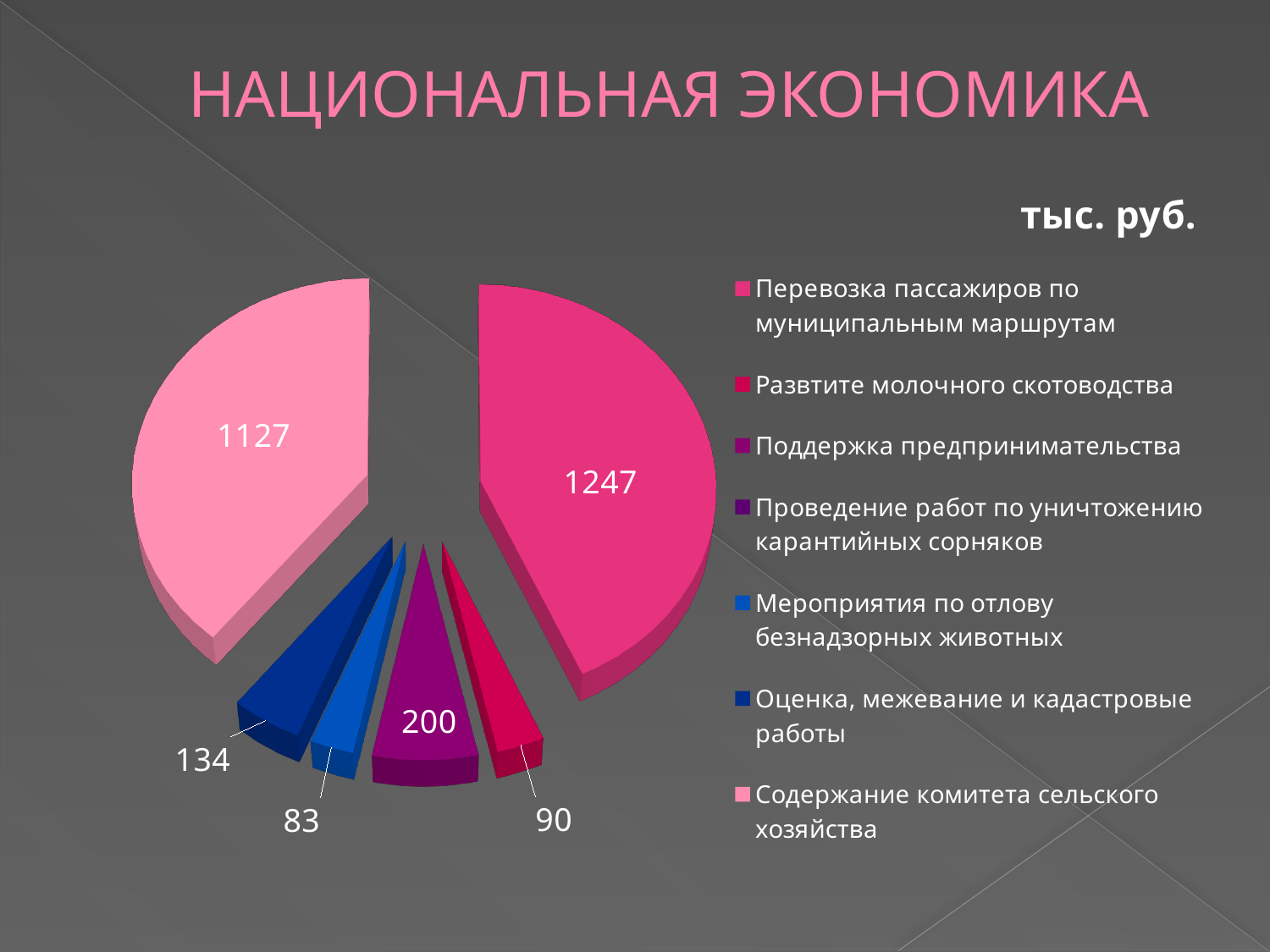
What kind of chart is shown on the slide? pie chart What is the difference between the values for Перевозка пассажиров по муниципальным маршрутам and Содержание комитета сельского хозяйства? 120 What is the value for Оценка, межевание и кадастровые работы? 134 Which category has the highest value? Перевозка пассажиров по муниципальным маршрутам What is the value for Развтите молочного скотоводства? 90 What is the value for Мероприятия по отлову безнадзорных животных? 83 What unit is indicated above the legend? тыс. руб. What is the value for Содержание комитета сельского хозяйства? 1127 How many categories does the legend list? 7 Which is larger: the value for Поддержка предпринимательства or the value for Оценка, межевание и кадастровые работы? Поддержка предпринимательства What is the value for Перевозка пассажиров по муниципальным маршрутам? 1247 What is the value for Поддержка предпринимательства? 200